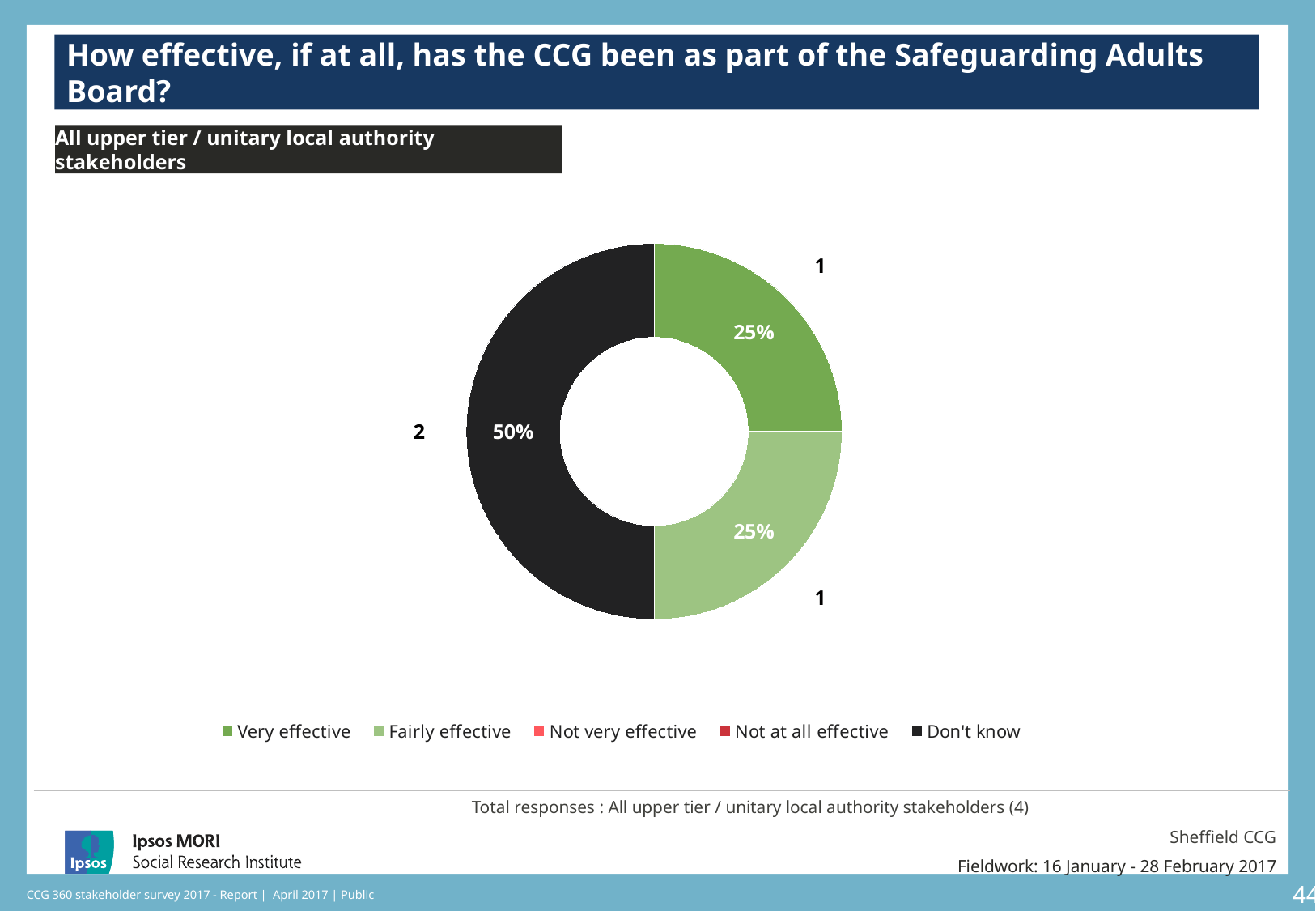
Which response category has the largest share of the chart? Don't know Which stakeholder group does the chart cover? All upper tier / unitary local authority stakeholders What percentage of respondents answered 'Don't know'? 50% How many entries does the legend list? 5 What percentage of respondents said 'Fairly effective'? 25% What percentage of respondents said the CCG has been 'Very effective' as part of the Safeguarding Adults Board? 25% What colour is the 'Don't know' segment of the chart? Black What kind of chart is shown on the slide? Donut (pie) chart How many respondents answered 'Don't know'? 2 What is the difference in percentage points between 'Don't know' and 'Very effective'? 25 percentage points Is the share for 'Don't know' larger or smaller than the share for 'Fairly effective'? Larger What is the total number of responses shown for the chart? 4